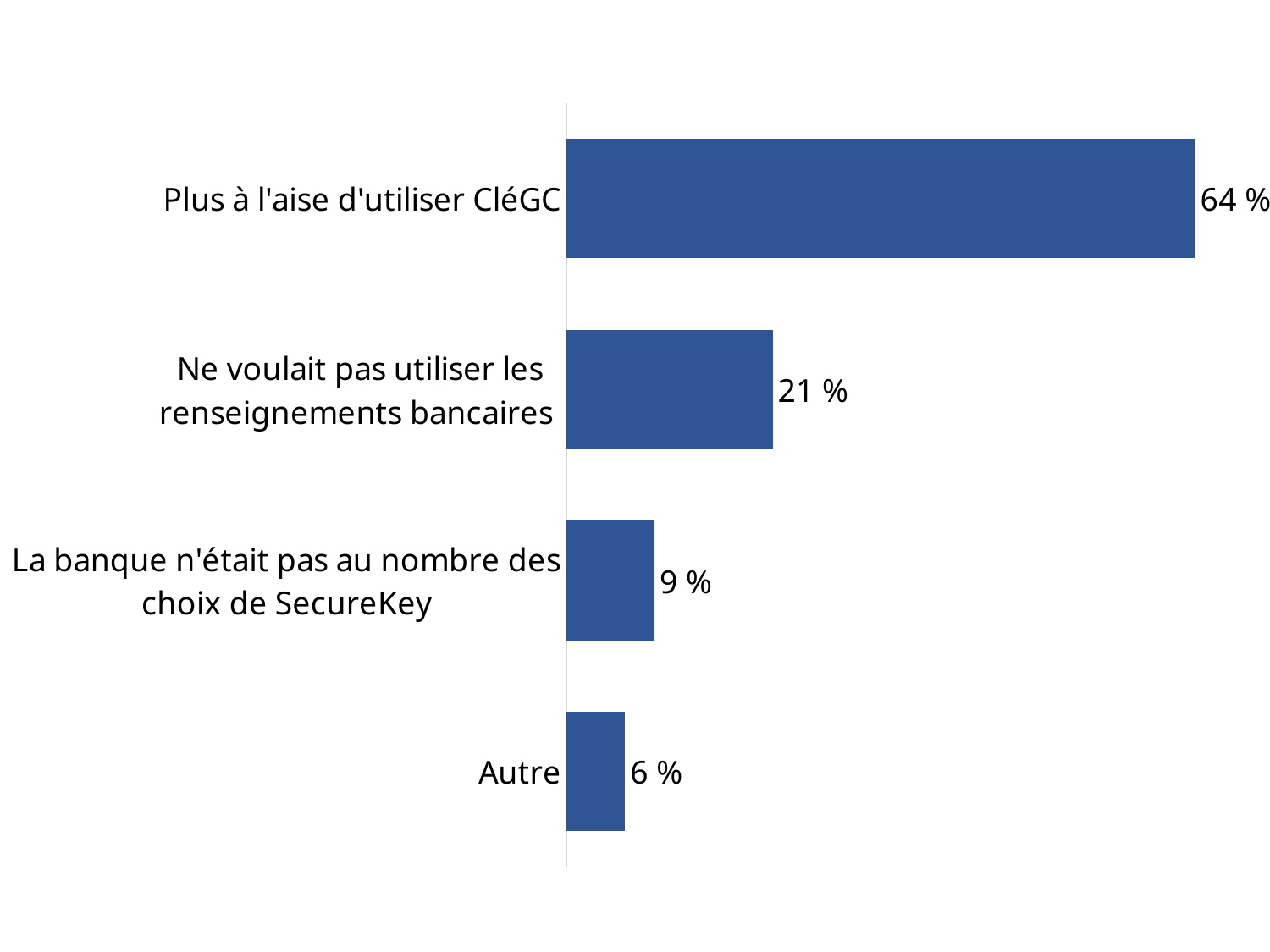
What is the value for "Ne voulait pas utiliser les renseignements bancaires"? 21 % How many categories are shown in the chart? 4 What is the value for "La banque n'était pas au nombre des choix de SecureKey"? 9 % What is the difference between the values for "Plus à l'aise d'utiliser CléGC" and "Ne voulait pas utiliser les renseignements bancaires"? 43 % Which category has the lowest value? Autre Which is larger: the value for "Ne voulait pas utiliser les renseignements bancaires" or the value for "La banque n'était pas au nombre des choix de SecureKey"? Ne voulait pas utiliser les renseignements bancaires What is the value for "Autre"? 6 % What colour are the bars in the chart? Blue What kind of chart is shown on the slide? Bar chart What is the value for "Plus à l'aise d'utiliser CléGC"? 64 % Which category has the highest value? Plus à l'aise d'utiliser CléGC What is the difference between the values for "La banque n'était pas au nombre des choix de SecureKey" and "Autre"? 3 %